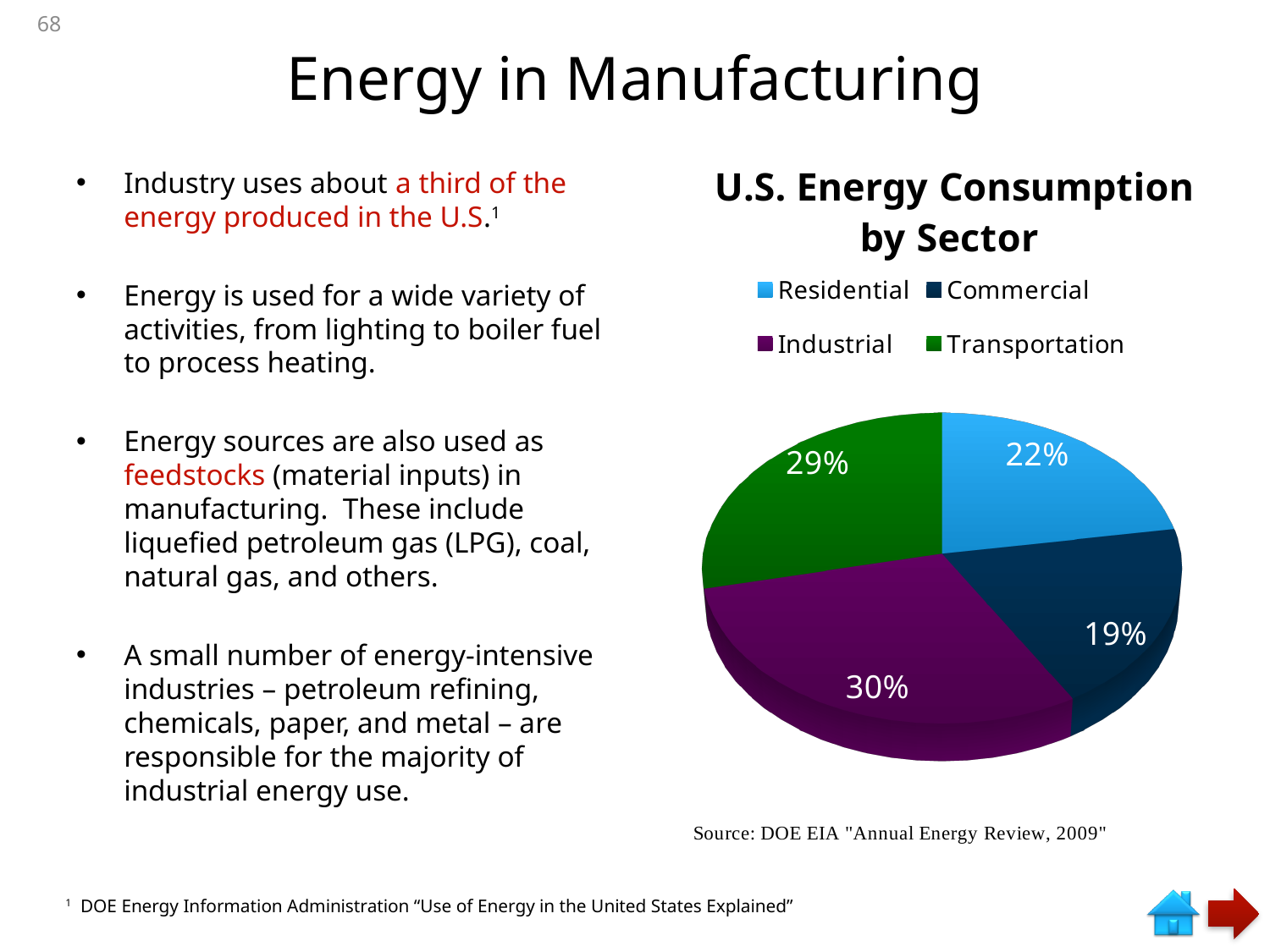
What share of U.S. energy consumption does the Commercial sector account for? 19% What colour represents the Industrial sector in the pie chart? Purple What is the difference in percentage points between the Industrial and Commercial shares? 11 What share of U.S. energy consumption does the Transportation sector account for? 29% Which sector has a larger share, Residential or Commercial? Residential Which sector has the largest share of U.S. energy consumption? Industrial How many sectors are shown in the pie chart? 4 What type of chart is used to show U.S. Energy Consumption by Sector? Pie chart What share of U.S. energy consumption does the Industrial sector account for? 30% What is the title of the chart? U.S. Energy Consumption by Sector What share of U.S. energy consumption does the Residential sector account for? 22% Which sector has the smallest share of U.S. energy consumption? Commercial